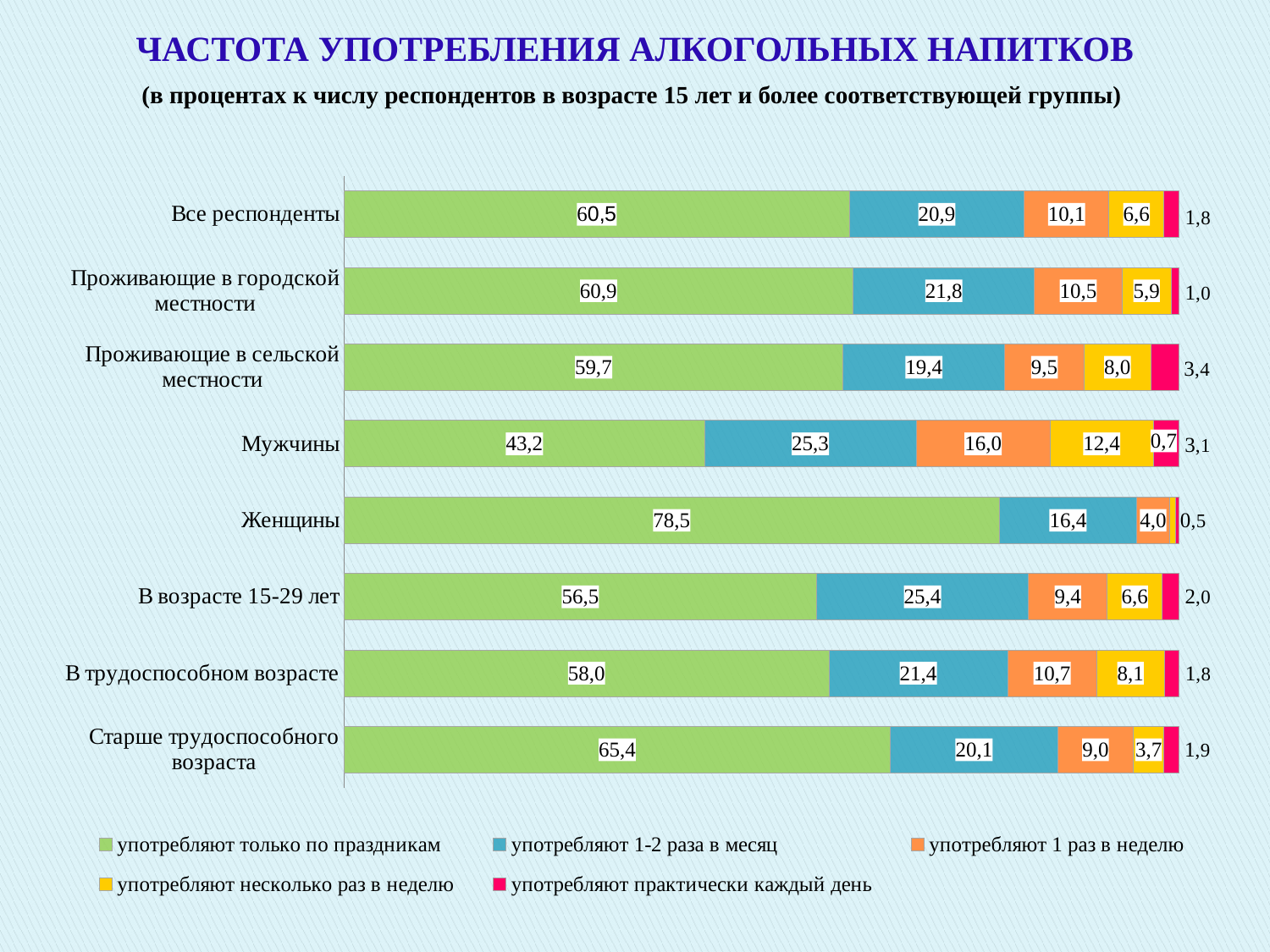
What is the value for 'употребляют несколько раз в неделю' among 'Старше трудоспособного возраста'? 3,7 What is the total of the stacked bar for 'Все респонденты'? 99,9 Which has the larger value for 'употребляют 1-2 раза в месяц': 'Проживающие в городской местности' or 'Проживающие в сельской местности'? Проживающие в городской местности What is the value for 'употребляют практически каждый день' among 'Проживающие в сельской местности'? 3,4 What type of chart is shown on the slide? Stacked bar chart Which group has the highest value for 'употребляют только по праздникам'? Женщины What is the value for 'употребляют 1 раз в неделю' among 'Мужчины'? 16,0 How many respondent groups (categories) are shown on the chart? 8 What is the difference between 'Женщины' and 'Мужчины' for 'употребляют только по праздникам'? 35,3 Which group has the lowest value for 'употребляют только по праздникам'? Мужчины How many series does the legend list? 5 What is the value for 'употребляют только по праздникам' among 'Женщины'? 78,5